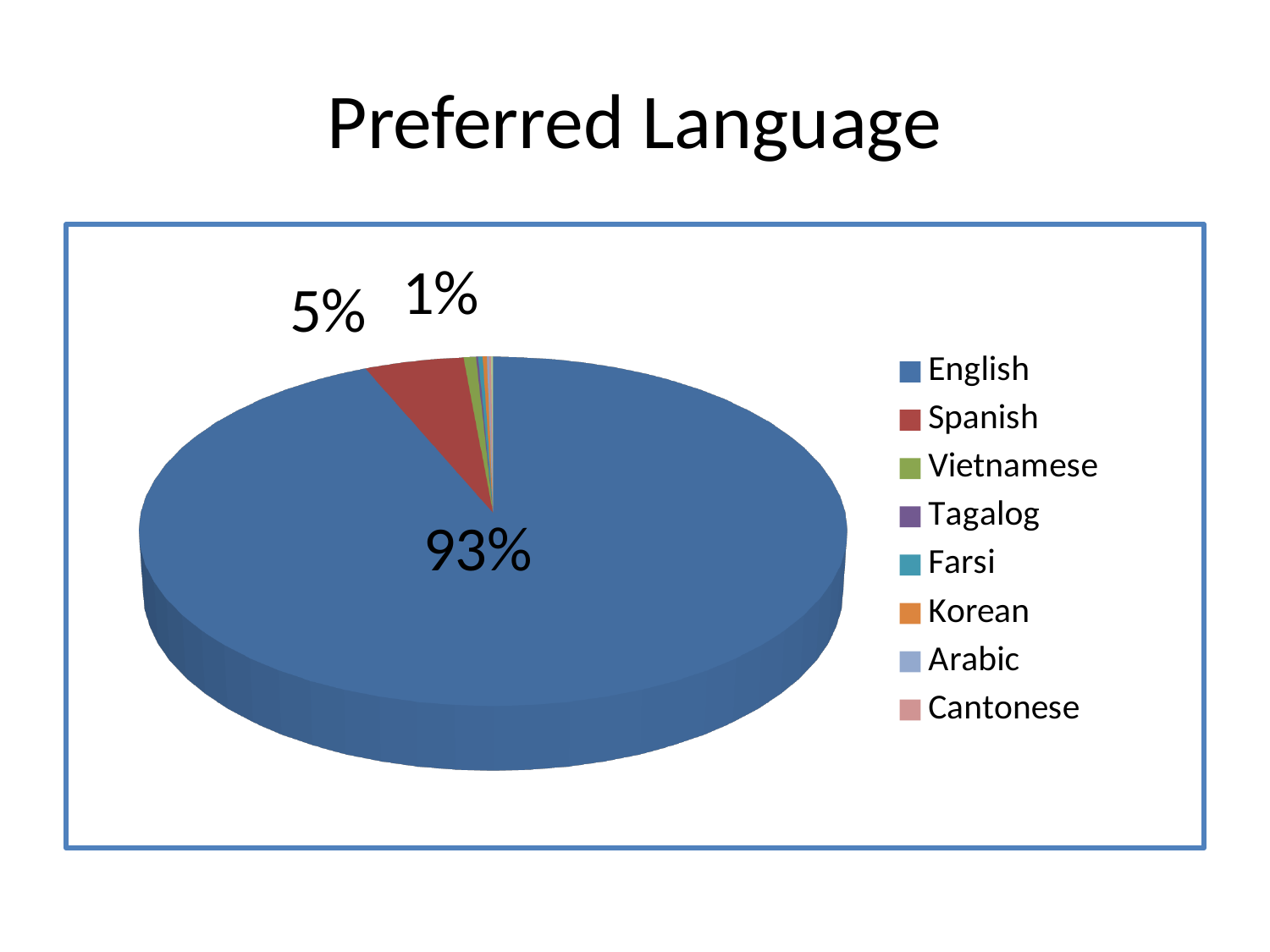
Which language is listed last in the legend? Cantonese What percentage is shown for Spanish? 5% Which slice is larger, English or Spanish? English What share of the pie does English account for? 93% How many languages are listed in the legend? 8 What is the title of the chart? Preferred Language What is the difference in percentage points between the English and Spanish slices? 88 What colour is the English slice of the pie? blue What kind of chart is shown on the slide? pie chart Which language has the largest slice of the pie? English